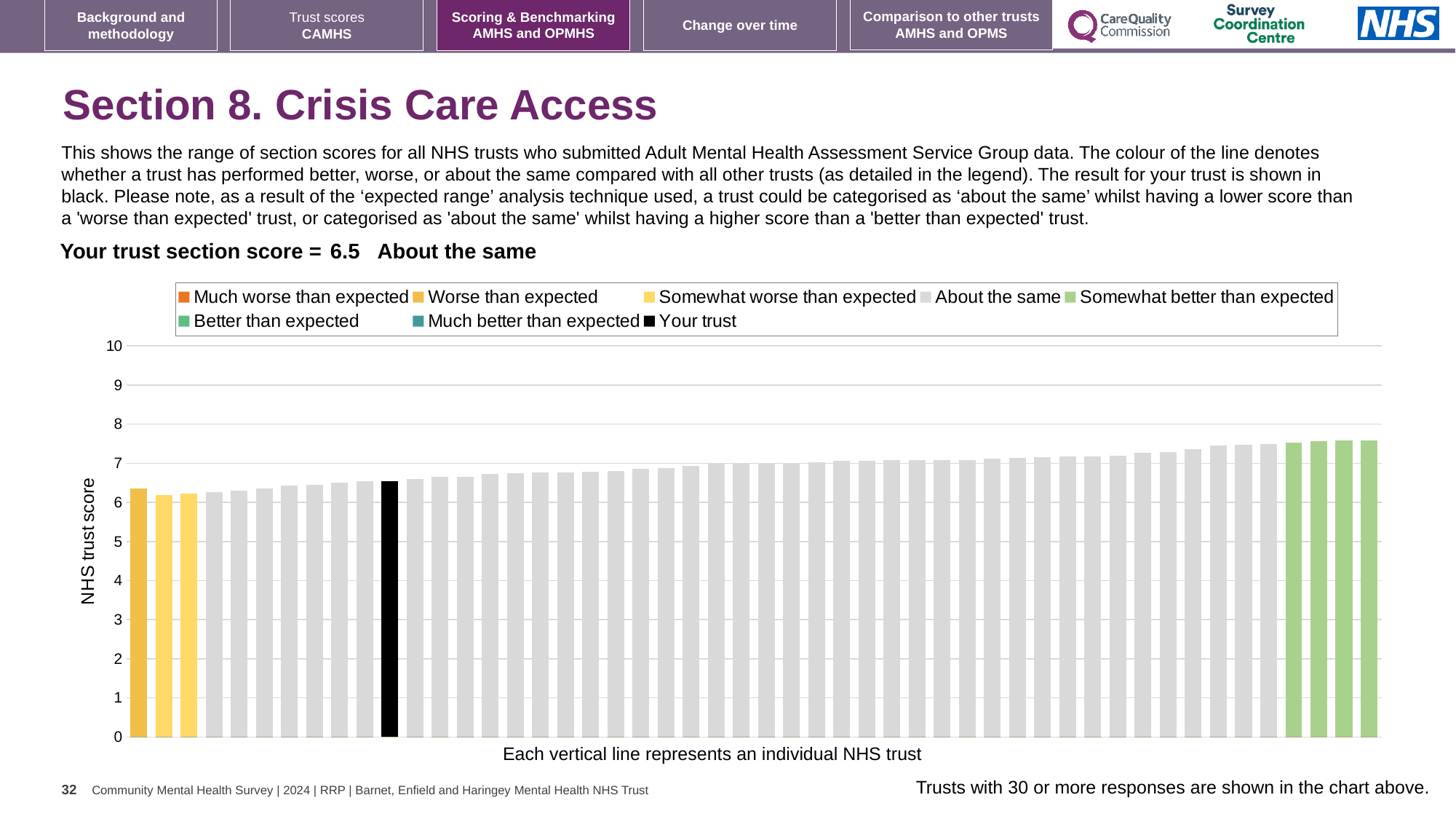
What kind of chart is shown on the slide? bar chart Is the value of the tallest bar greater or less than 8? less How many entries does the chart legend list? 8 Is the value for your trust greater or less than 7? less Which performance category is your trust placed in for this section? About the same Is the value for your trust greater or less than 6? greater Which is taller: the black bar for your trust or the rightmost green bar? the rightmost green bar How many bars are coloured green (somewhat better than expected)? 4 What is the section score for your trust shown on the slide? 6.5 What colour is used in the legend for 'Your trust'? black Do the bar values rise or fall from left to right along the x axis? rise